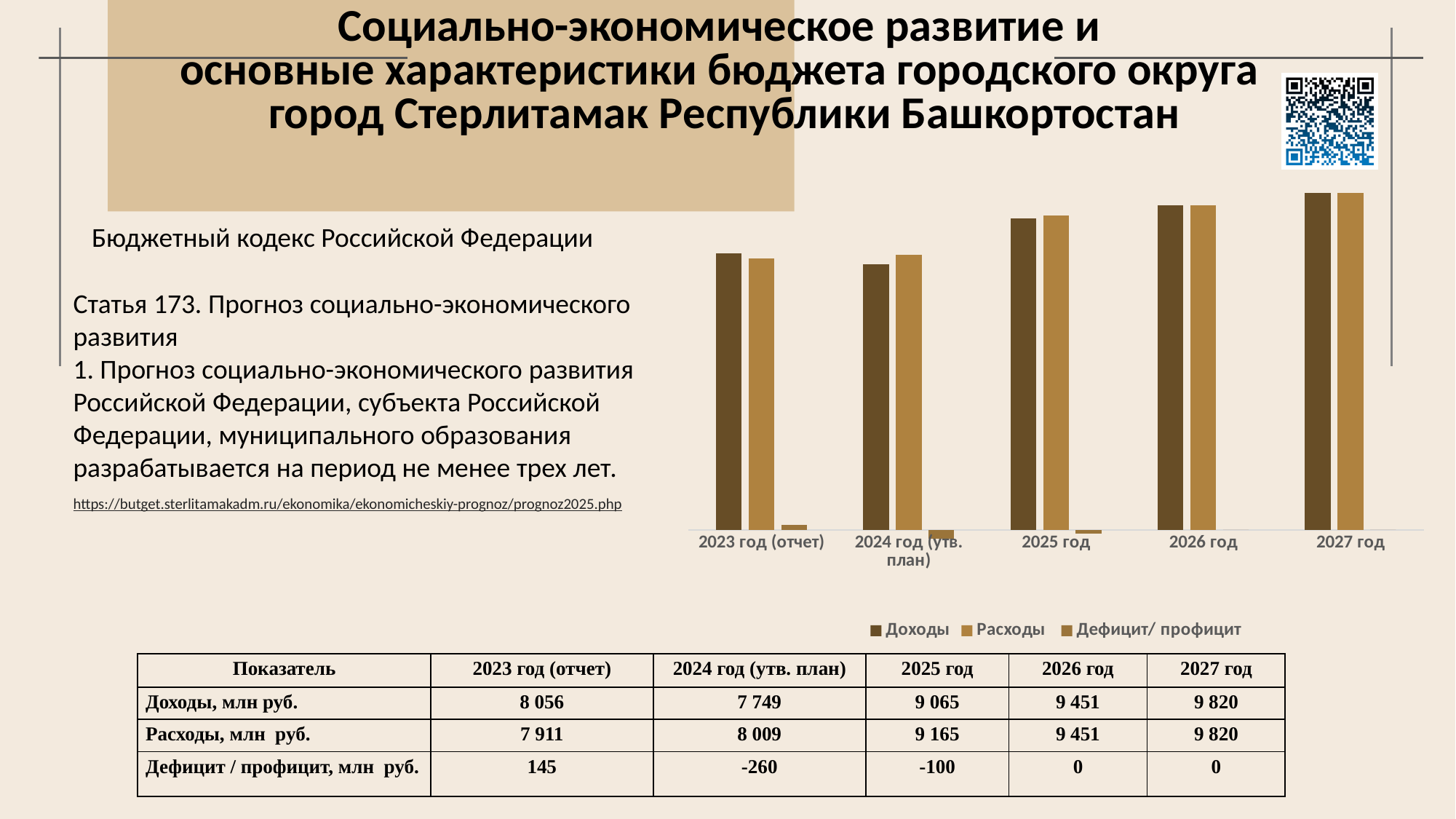
How many series does the chart legend list? 3 Do the Расходы values rise or fall from 2023 год (отчет) to 2027 год? rise What is the value of Расходы for 2024 год (утв. план)? 8 009 What kind of chart is shown on the slide? bar chart In which year is Доходы the highest? 2027 год How many year categories are shown on the x axis of the chart? 5 Which is larger for 2023 год (отчет): Доходы or Расходы? Доходы What is the value of Дефицит/профицит for 2023 год (отчет)? 145 What is the difference between Расходы and Доходы for 2025 год? 100 What is the value of Доходы for 2025 год? 9 065 Which series is shown in the darkest brown colour in the chart? Доходы In which year is Доходы the lowest? 2024 год (утв. план)